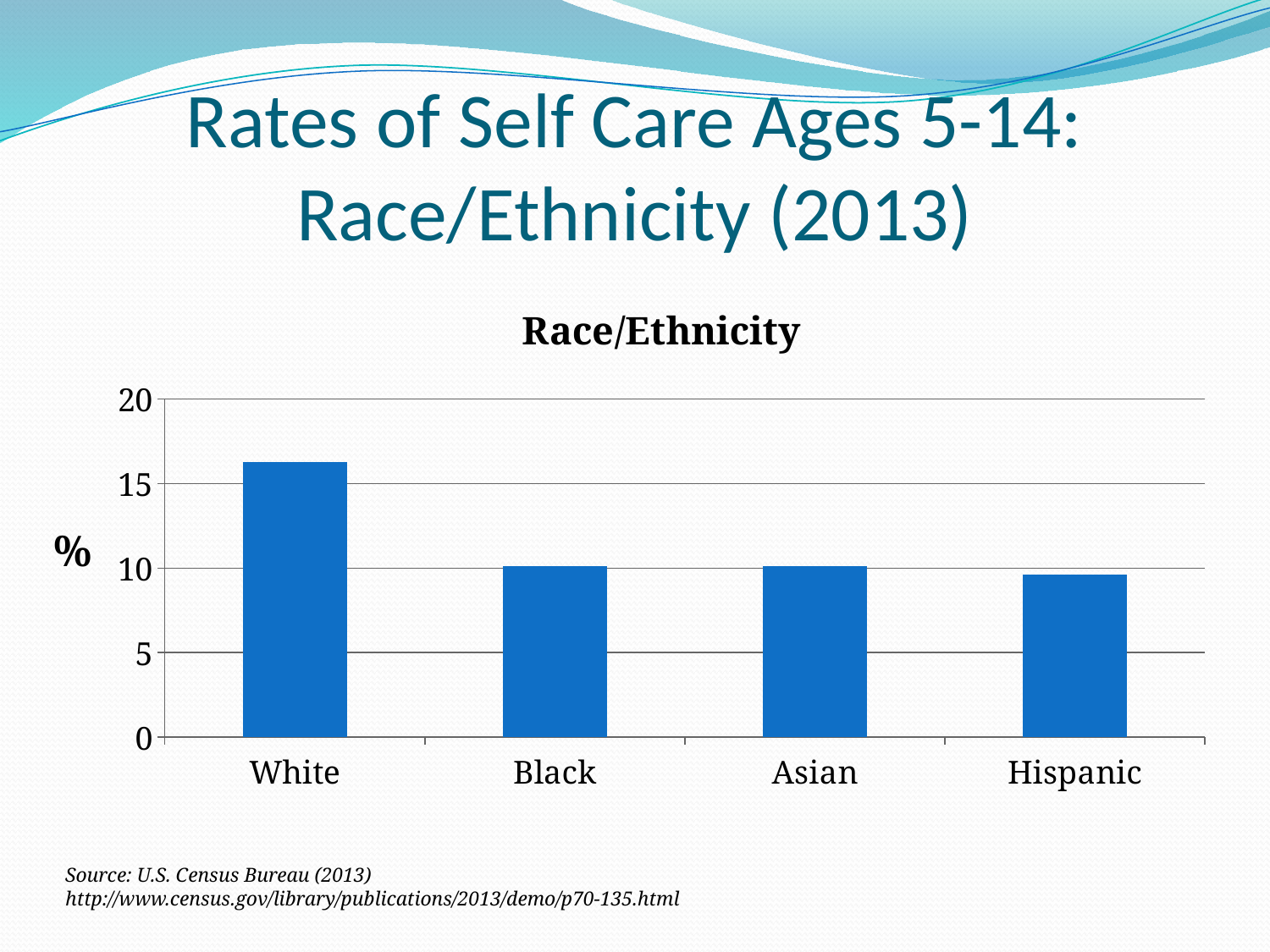
Which is larger, the value for Asian or the value for White? White Is the value for Black greater or less than 5? greater Which race/ethnicity category has the lowest rate of self care? Hispanic Is the value for Hispanic greater or less than 10? less What kind of chart is shown on the slide? bar chart Is the value for White greater or less than 15? greater Which race/ethnicity category has the highest rate of self care? White What is the title printed above the chart? Race/Ethnicity Which is larger, the value for White or the value for Black? White How many race/ethnicity categories are plotted in the chart? 4 What label is shown on the vertical axis of the chart? %